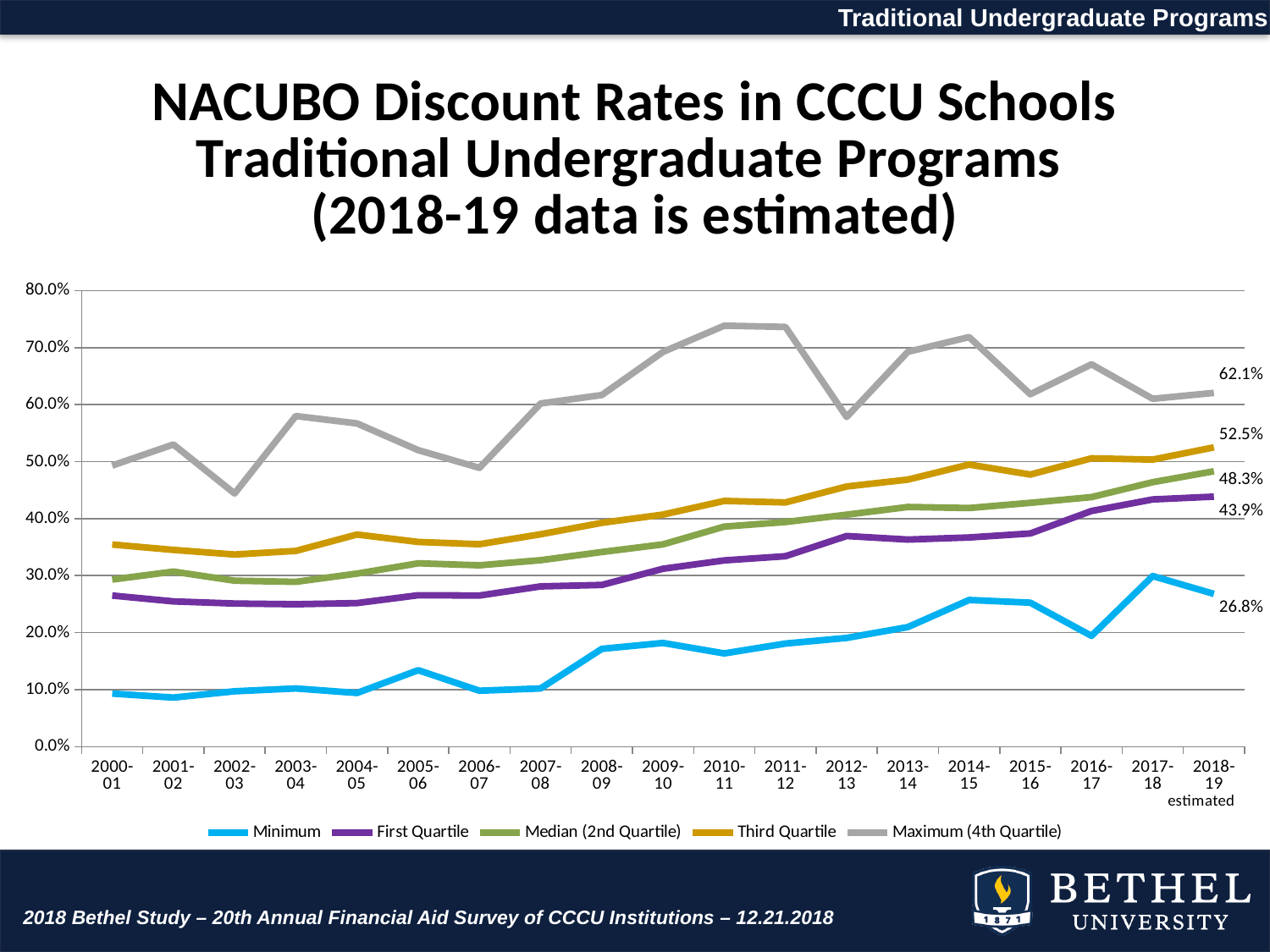
How many academic years are shown on the x axis? 19 Is the value of the Maximum (4th Quartile) series for 2010-11 greater or less than 70.0%? greater What kind of chart is shown on the slide? Line chart How many series does the legend list? 5 What is the value of the Minimum series for 2018-19 estimated? 26.8% What is the value of the Median (2nd Quartile) series for 2018-19 estimated? 48.3% What is the value of the Third Quartile series for 2018-19 estimated? 52.5% What is the difference between the Maximum (4th Quartile) and Minimum values for 2018-19 estimated? 35.3 percentage points Is the value of the Maximum (4th Quartile) series for 2002-03 greater or less than 50.0%? less Which series has the highest value for 2018-19 estimated? Maximum (4th Quartile) What is the value of the Maximum (4th Quartile) series for 2018-19 estimated? 62.1% Which is larger for 2018-19 estimated, the Median (2nd Quartile) or the First Quartile? Median (2nd Quartile)